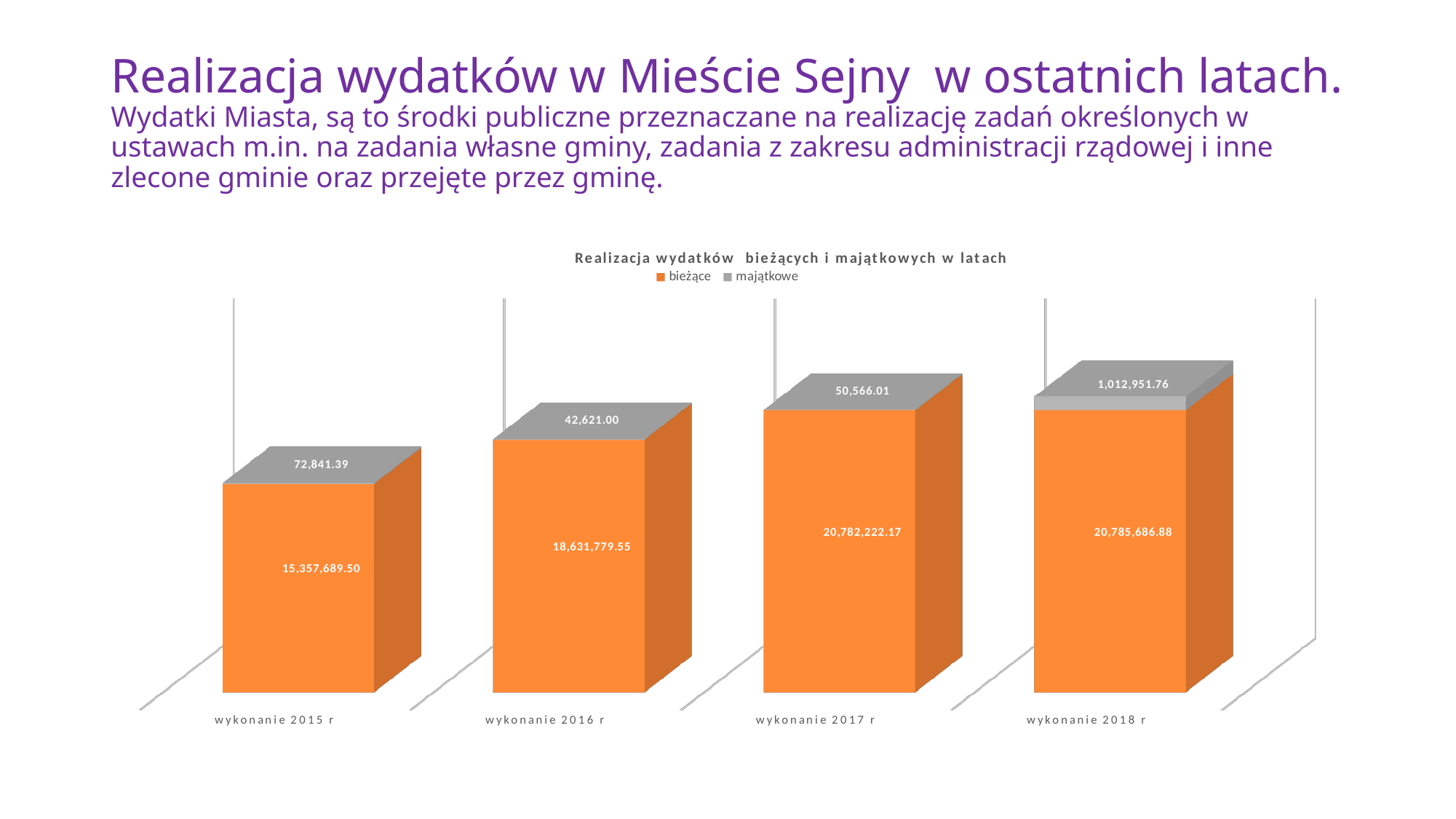
Which year has the highest value for bieżące? wykonanie 2018 r What is the value of majątkowe for wykonanie 2018 r? 1,012,951.76 How many series does the legend list? 2 What is the difference between the bieżące values for wykonanie 2016 r and wykonanie 2015 r? 3,274,090.05 What is the total of the stacked bar for wykonanie 2017 r? 20,832,788.18 Do the bieżące values rise or fall from wykonanie 2015 r to wykonanie 2018 r? Rise What kind of chart is shown on the slide? Stacked bar chart What is the value of majątkowe for wykonanie 2016 r? 42,621.00 Which year has the lowest value for majątkowe? wykonanie 2016 r How many years (categories) are shown on the chart? 4 What is the value of bieżące for wykonanie 2015 r? 15,357,689.50 Which is larger, the majątkowe value for wykonanie 2017 r or for wykonanie 2015 r? wykonanie 2015 r